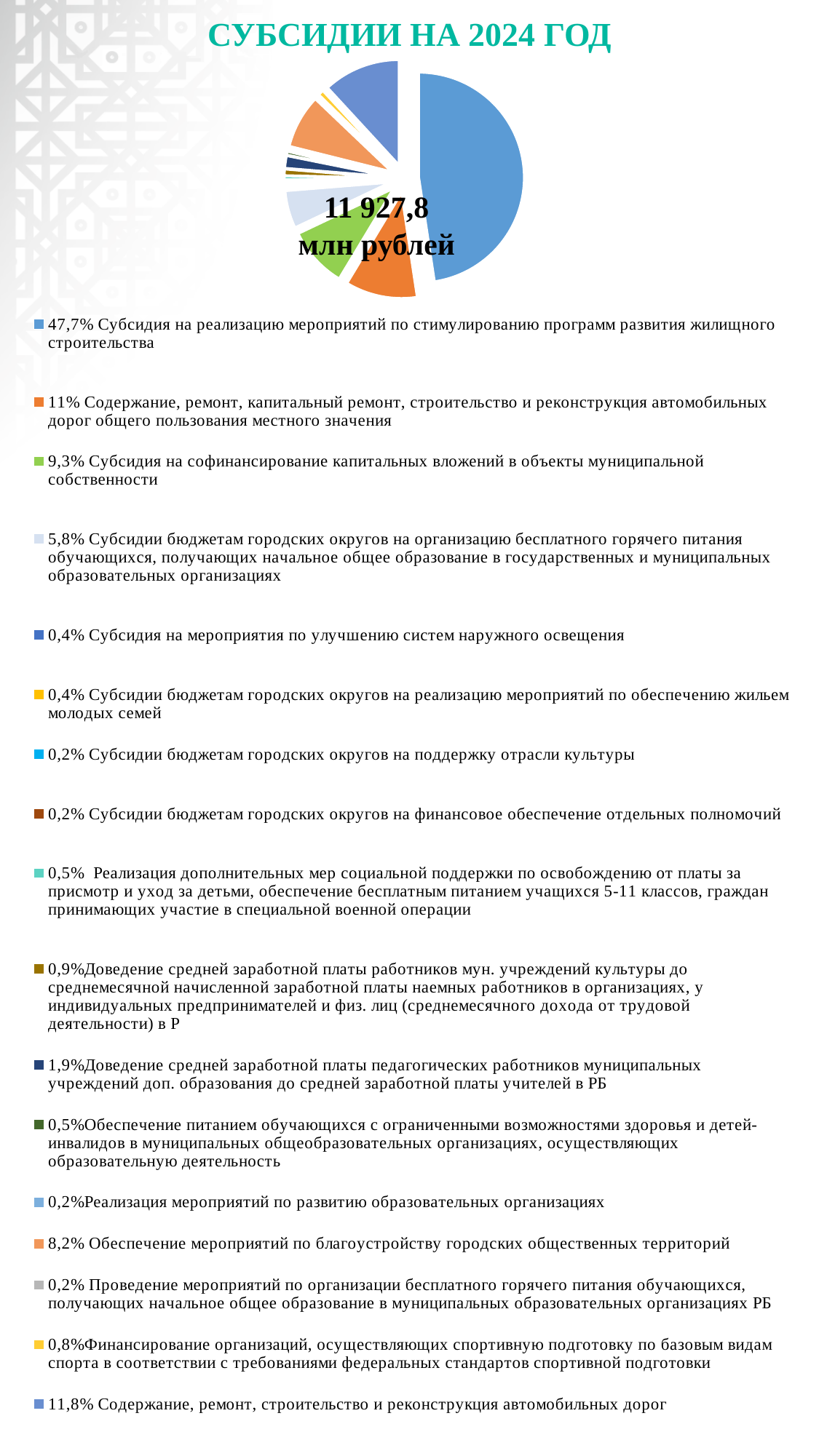
What kind of chart is shown on the slide? pie chart What share of the pie is 'Содержание, ремонт, строительство и реконструкция автомобильных дорог'? 11,8% What share of the pie is the subsidy for stimulating housing construction development programmes (Субсидия на реализацию мероприятий по стимулированию программ развития жилищного строительства)? 47,7% What is the title of the chart? СУБСИДИИ НА 2024 ГОД What share of the pie is 'Обеспечение мероприятий по благоустройству городских общественных территорий'? 8,2% What is the difference in share between 'Содержание, ремонт, строительство и реконструкция автомобильных дорог' (11,8%) and 'Содержание, ремонт, капитальный ремонт, строительство и реконструкция автомобильных дорог общего пользования местного значения' (11%)? 0,8% What is the smallest percentage shown in the legend? 0,2% What total amount is printed in the centre of the pie chart? 11 927,8 млн рублей Which has the larger share: the subsidy for free hot meals for primary school pupils (5,8%) or the subsidy for improving outdoor lighting systems (0,4%)? Субсидии бюджетам городских округов на организацию бесплатного горячего питания обучающихся Which category has the largest share of the pie? Субсидия на реализацию мероприятий по стимулированию программ развития жилищного строительства How many categories does the legend list? 17